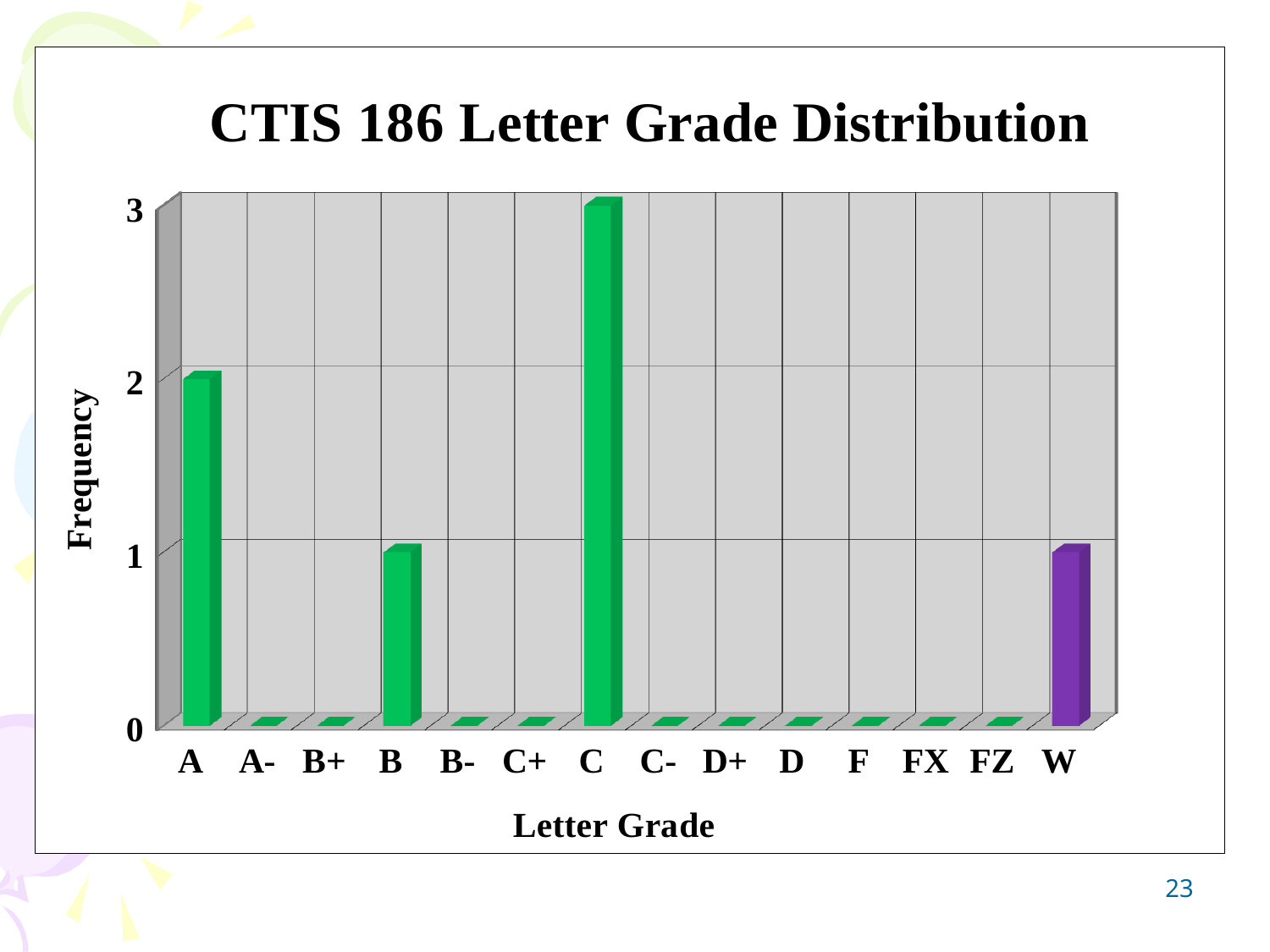
What is the difference in frequency between C and A? 1 What is the frequency for W? 1 What is the frequency for letter grade A? 2 What is the frequency for letter grade C? 3 What is the label of the y axis? Frequency What is the title of the chart? CTIS 186 Letter Grade Distribution Which letter grade has the highest frequency? C What kind of chart is shown on the slide? bar chart Which has a higher frequency, A or B? A How many letter grade categories are shown on the x axis? 14 What is the frequency for letter grade B? 1 What is the frequency for letter grade D? 0